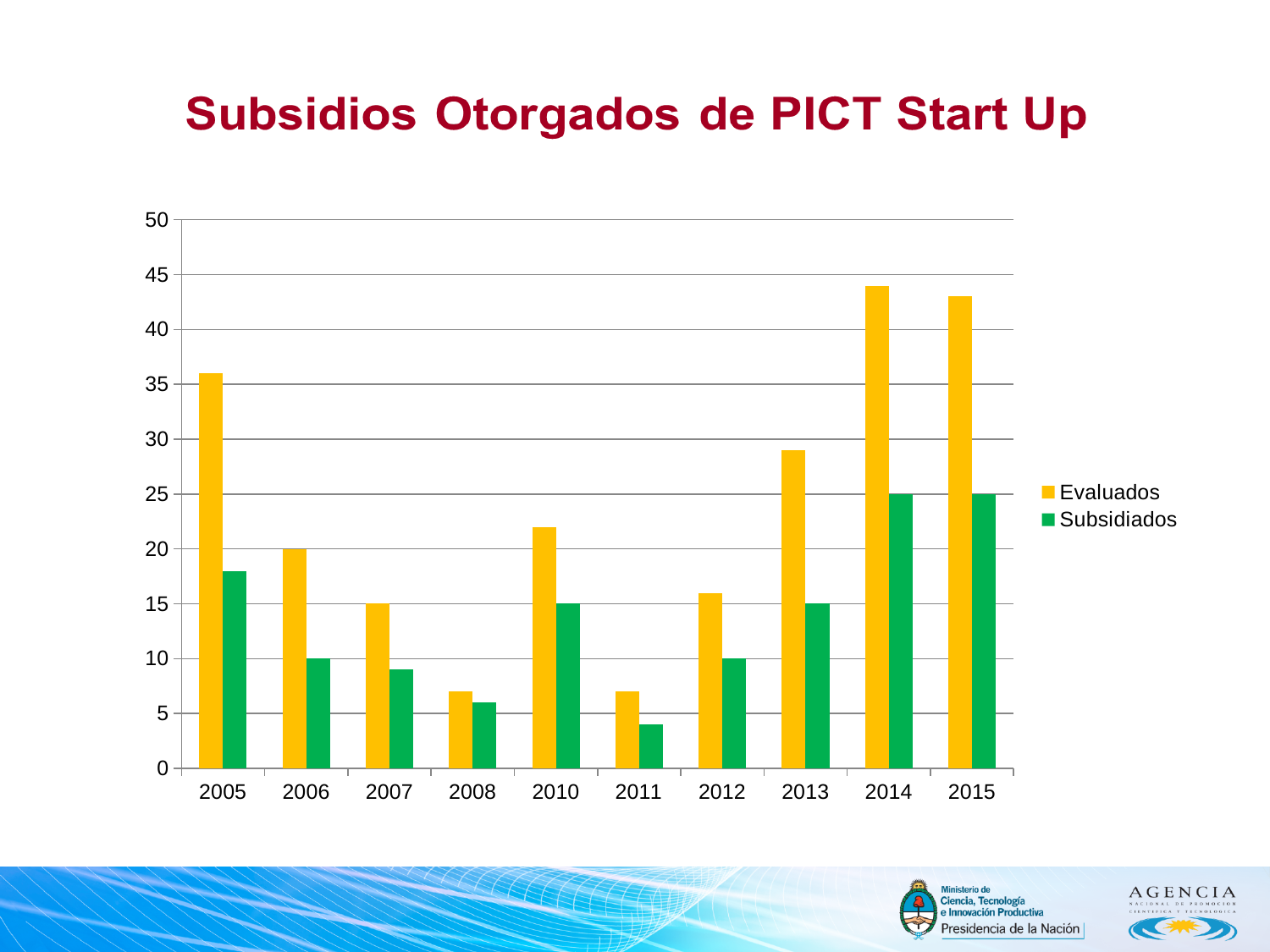
What is the Subsidiados value for 2013? 15 Is the Evaluados value for 2014 greater or less than 40? greater How many years are shown on the x axis? 10 What is the difference between the Subsidiados values for 2014 and 2013? 10 What is the title of the chart? Subsidios Otorgados de PICT Start Up Which year has the lowest Subsidiados value? 2011 What is the Evaluados value for 2007? 15 Is the Evaluados value for 2011 greater or less than 10? less What is the Subsidiados value for 2014? 25 How many series does the legend list? 2 What kind of chart is shown on the slide? bar chart Which is larger, the Evaluados value for 2005 or the Evaluados value for 2013? 2005